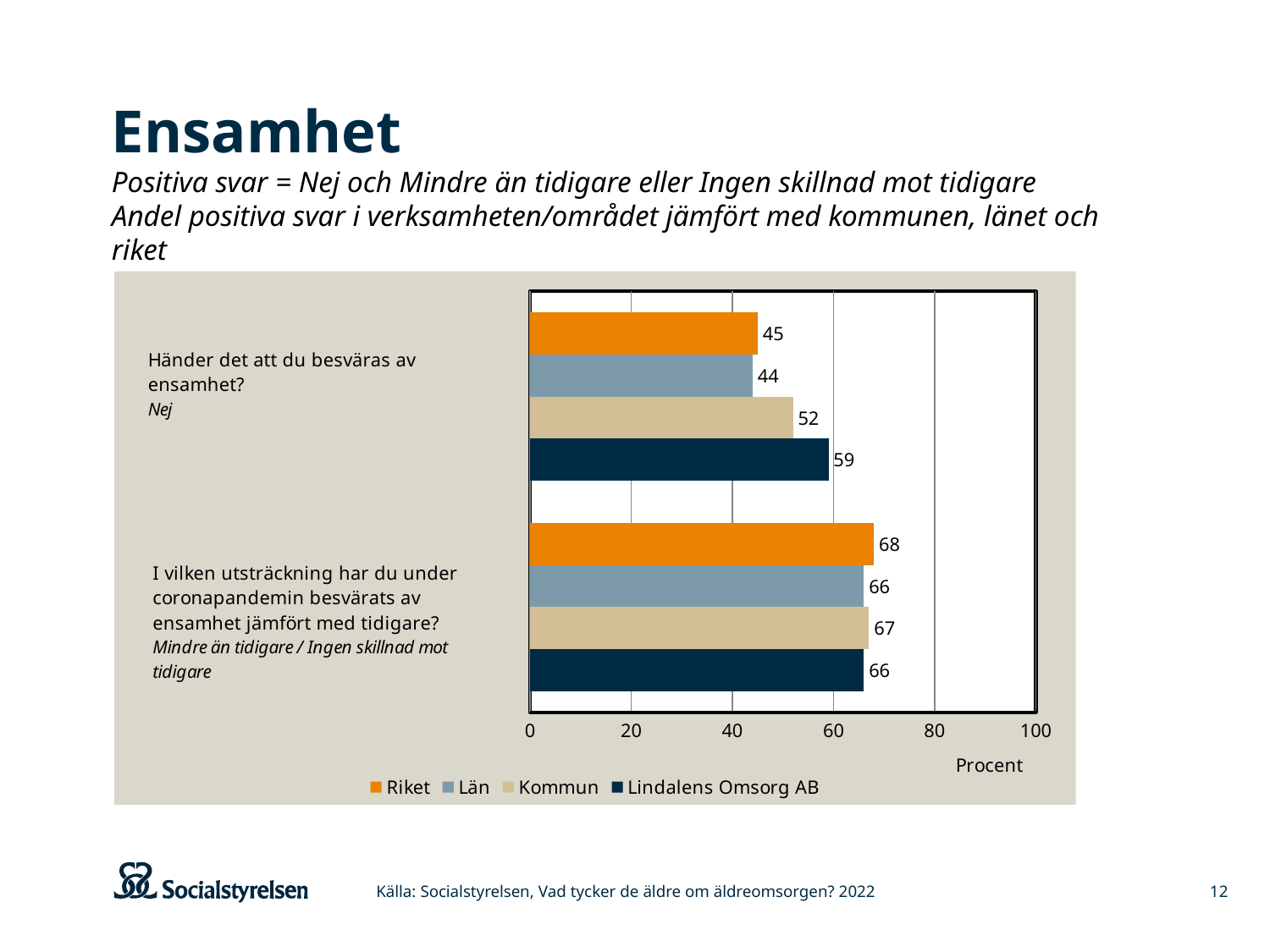
What is the label on the horizontal axis of the chart? Procent What kind of chart is shown on the slide? Bar chart What value is shown for Riket on the question 'Händer det att du besväras av ensamhet?' 45 Which is larger on the question 'I vilken utsträckning har du under coronapandemin besvärats av ensamhet jämfört med tidigare?': Riket or Kommun? Riket What value is shown for Lindalens Omsorg AB on the question 'Händer det att du besväras av ensamhet?' 59 Which series has the lowest value on the question 'Händer det att du besväras av ensamhet?' Län Which series is shown in orange in the legend? Riket How many series does the legend list? 4 What value is shown for Län on the question 'I vilken utsträckning har du under coronapandemin besvärats av ensamhet jämfört med tidigare?' 66 What is the difference between Lindalens Omsorg AB and Riket on the question 'Händer det att du besväras av ensamhet?' 14 Which series has the highest value on the question 'Händer det att du besväras av ensamhet?' Lindalens Omsorg AB What value is shown for Kommun on the question 'I vilken utsträckning har du under coronapandemin besvärats av ensamhet jämfört med tidigare?' 67